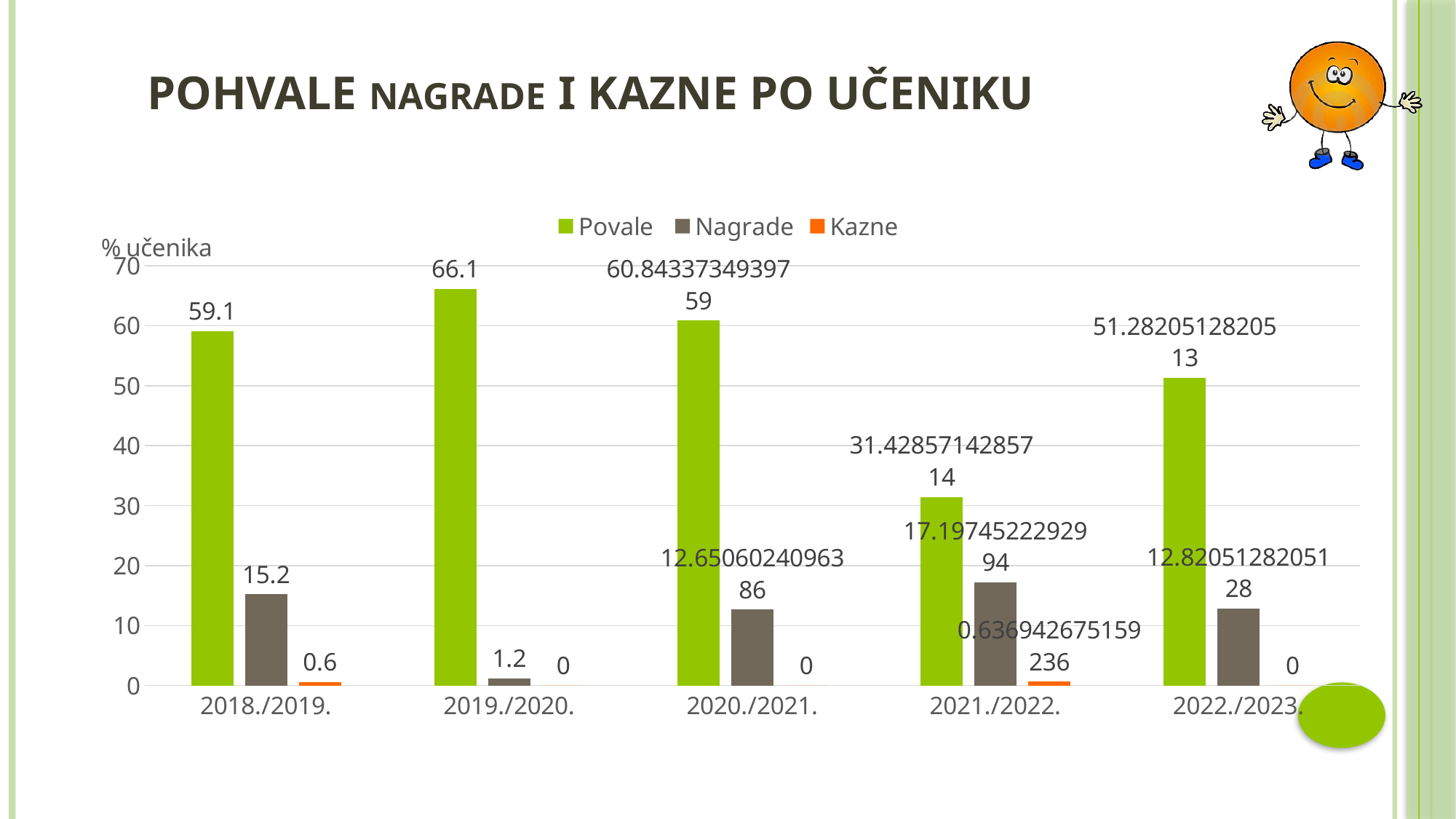
What is the value for Povale in 2019./2020.? 66.1 In which school year is the Povale value lowest? 2021./2022. How many school years are shown on the x axis? 5 What is the value for Nagrade in 2018./2019.? 15.2 What is the value for Povale in 2018./2019.? 59.1 In which school year is the Povale value highest? 2019./2020. Which is larger, the Nagrade value for 2018./2019. or for 2019./2020.? 2018./2019. How many series does the legend list? 3 Is the Povale value for 2022./2023. greater or less than 40? greater What is the difference between the Povale values for 2019./2020. and 2018./2019.? 7 What is the value for Kazne in 2019./2020.? 0 What is the value for Kazne in 2018./2019.? 0.6